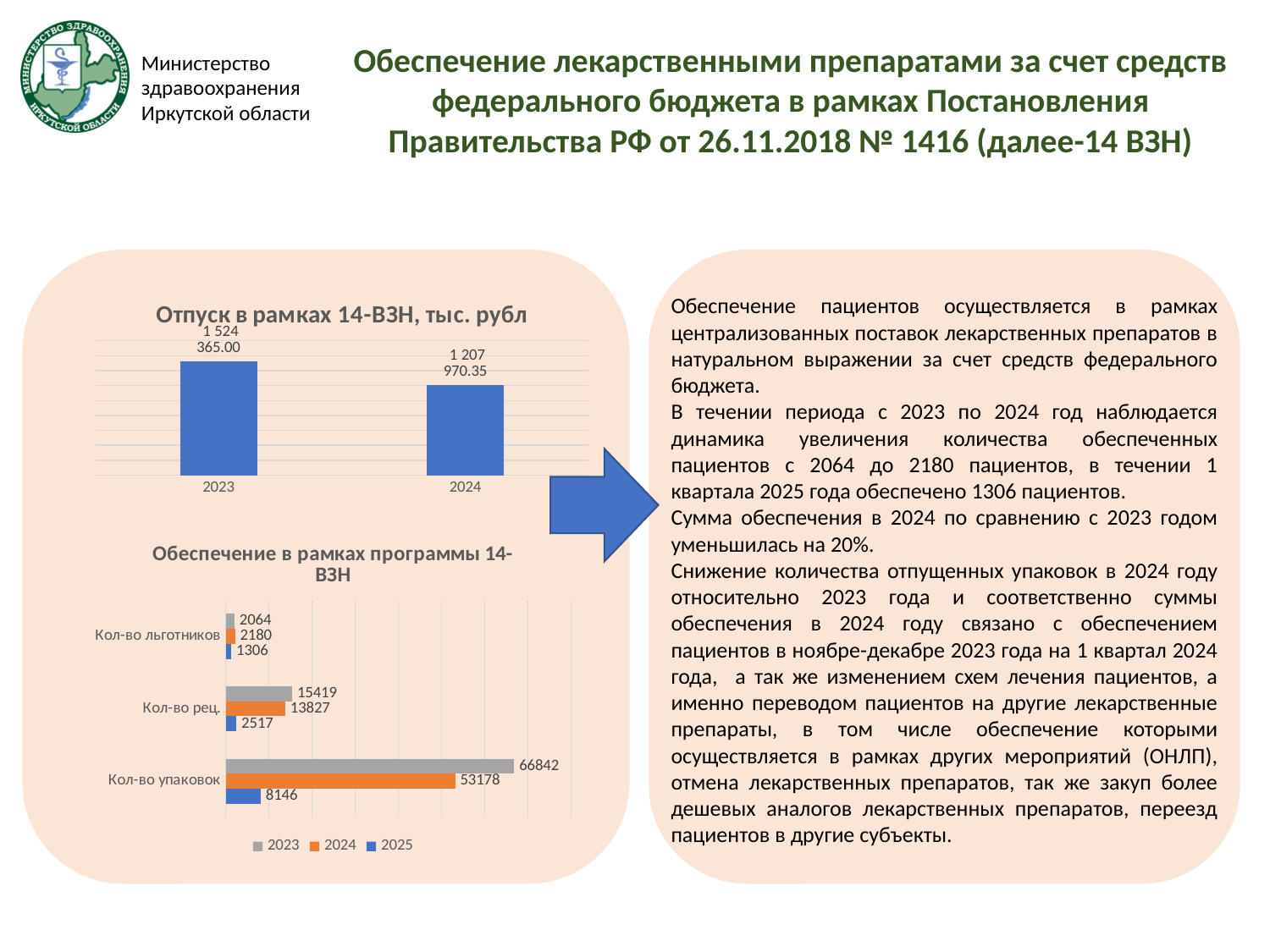
In the chart titled "Обеспечение в рамках программы 14-ВЗН", what is the 2025 value for Кол-во упаковок? 8146 In the chart titled "Обеспечение в рамках программы 14-ВЗН", how many series does the legend list? 3 In the chart titled "Обеспечение в рамках программы 14-ВЗН", what is the difference between the 2023 and 2024 values for Кол-во упаковок? 13664 In the chart titled "Обеспечение в рамках программы 14-ВЗН", what is the 2023 value for Кол-во рец.? 15419 In the chart titled "Отпуск в рамках 14-ВЗН, тыс. рубл", what is the value for 2024? 1 207 970.35 In the chart titled "Отпуск в рамках 14-ВЗН, тыс. рубл", which year has the higher value? 2023 In the chart titled "Обеспечение в рамках программы 14-ВЗН", which year has the lowest value for Кол-во рец.? 2025 What kind of chart is the one titled "Обеспечение в рамках программы 14-ВЗН"? Bar chart In the chart titled "Обеспечение в рамках программы 14-ВЗН", which colour represents the 2024 series? Orange In the chart titled "Отпуск в рамках 14-ВЗН, тыс. рубл", how many bars are plotted? 2 In the chart titled "Отпуск в рамках 14-ВЗН, тыс. рубл", what is the value for 2023? 1 524 365.00 In the chart titled "Обеспечение в рамках программы 14-ВЗН", what is the 2024 value for Кол-во льготников? 2180